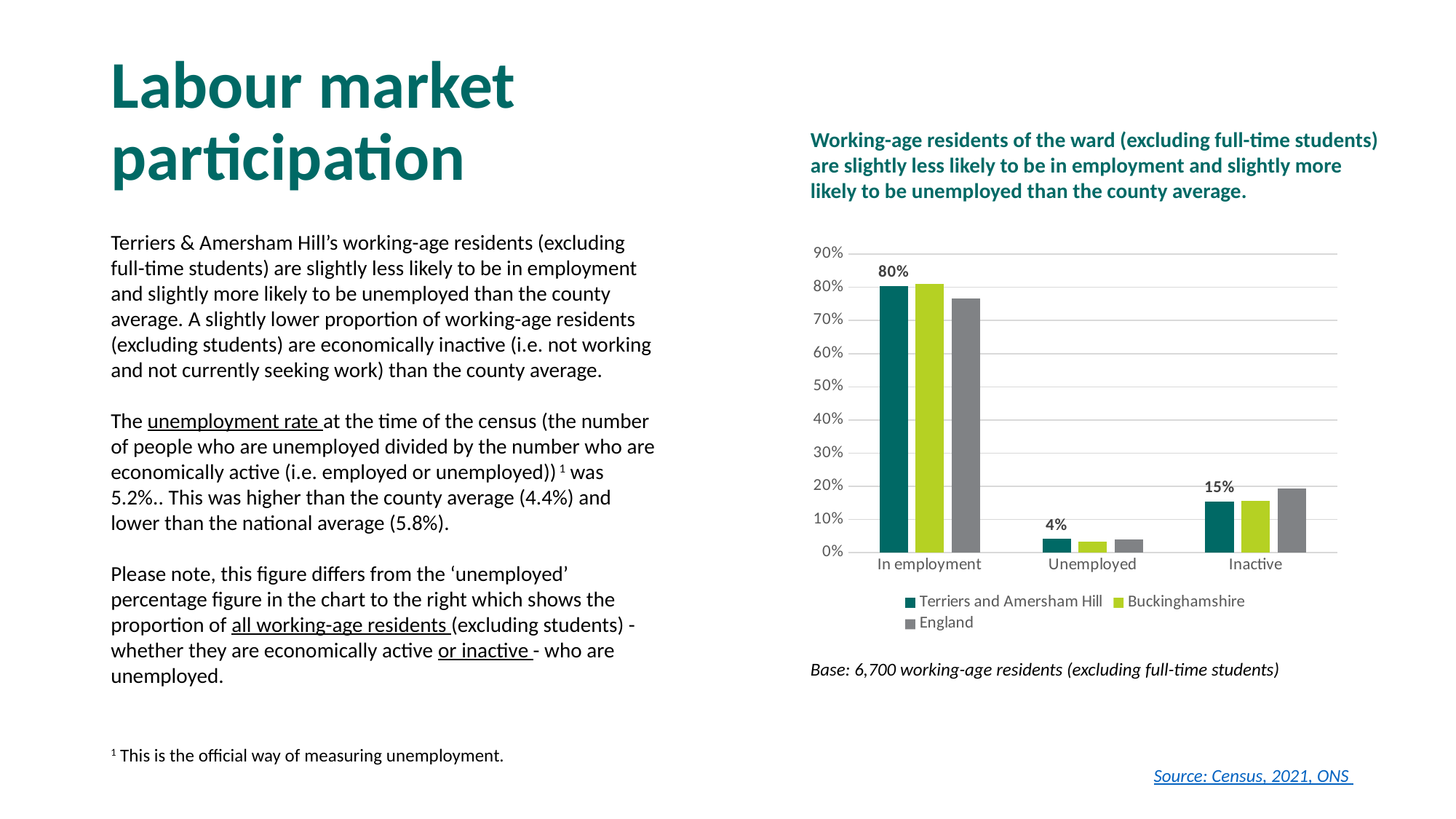
What type of chart is shown on the slide? Bar chart Which category has the lowest value for Terriers and Amersham Hill? Unemployed How many series does the chart legend list? 3 Is the value for England in the In employment category greater or less than 80%? less What percentage of working-age residents of Terriers and Amersham Hill are in employment? 80% What is the difference between the In employment and Inactive values for Terriers and Amersham Hill? 65% How many categories are shown on the x axis of the chart? 3 In the Inactive category, which is larger: Terriers and Amersham Hill or England? England What is the value for Terriers and Amersham Hill in the Inactive category? 15% What is the value for Terriers and Amersham Hill in the Unemployed category? 4% Which category has the highest value for Terriers and Amersham Hill? In employment